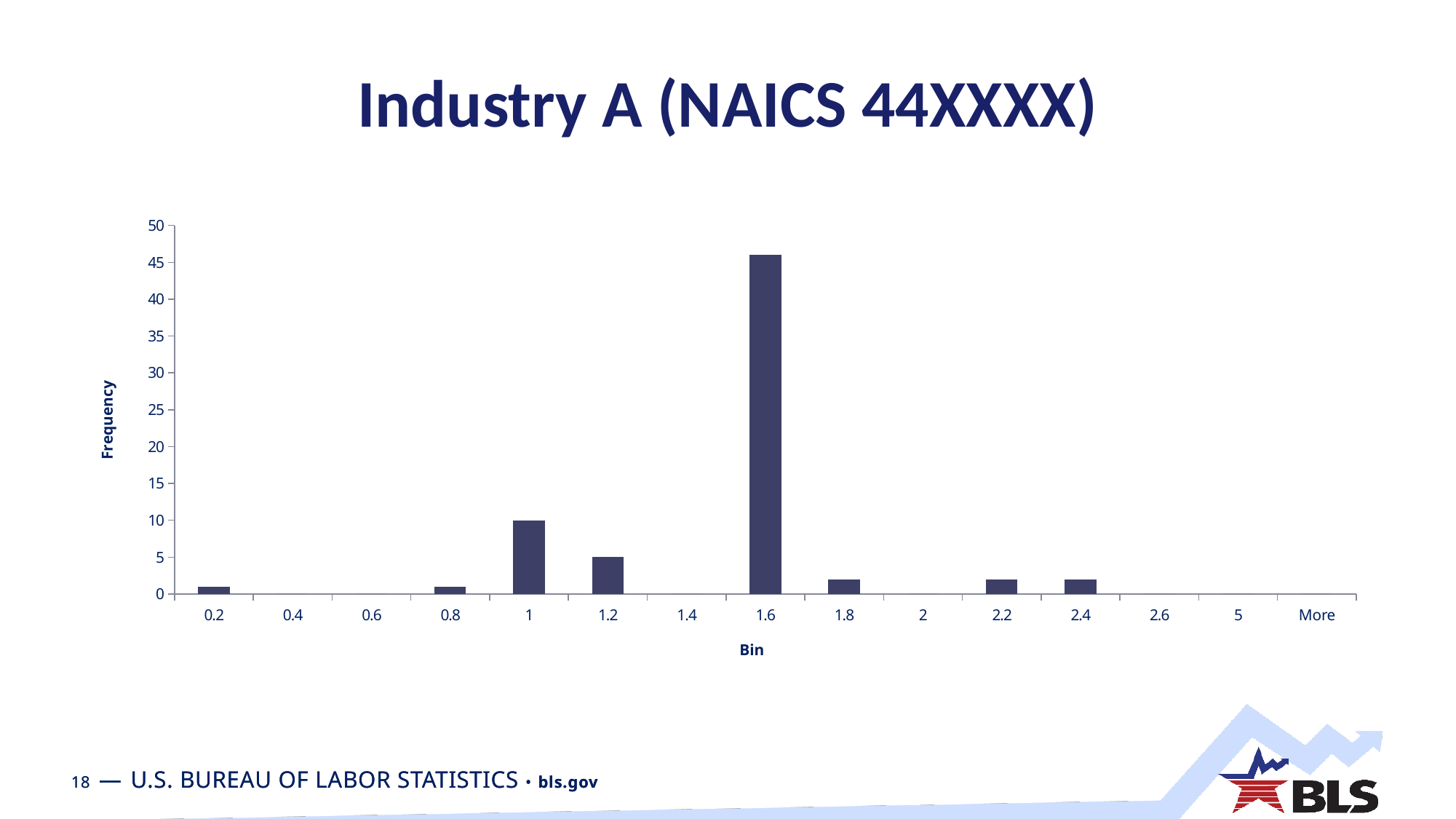
What is the title of the chart? Industry A (NAICS 44XXXX) Is the frequency for bin 1.8 greater or less than 5? less How many bins are labelled on the x axis? 15 Is the frequency for bin 0.2 greater or less than 5? less Which bin has the larger frequency, 1 or 1.2? 1 What is the label of the vertical axis? Frequency What is the frequency for bin 1.2? 5 Is the frequency for bin 1.6 greater or less than 40? greater Which bin has the larger frequency, 1.6 or 1? 1.6 What kind of chart is shown on the slide? bar chart Which bin has the highest frequency? 1.6 What is the frequency for bin 1? 10